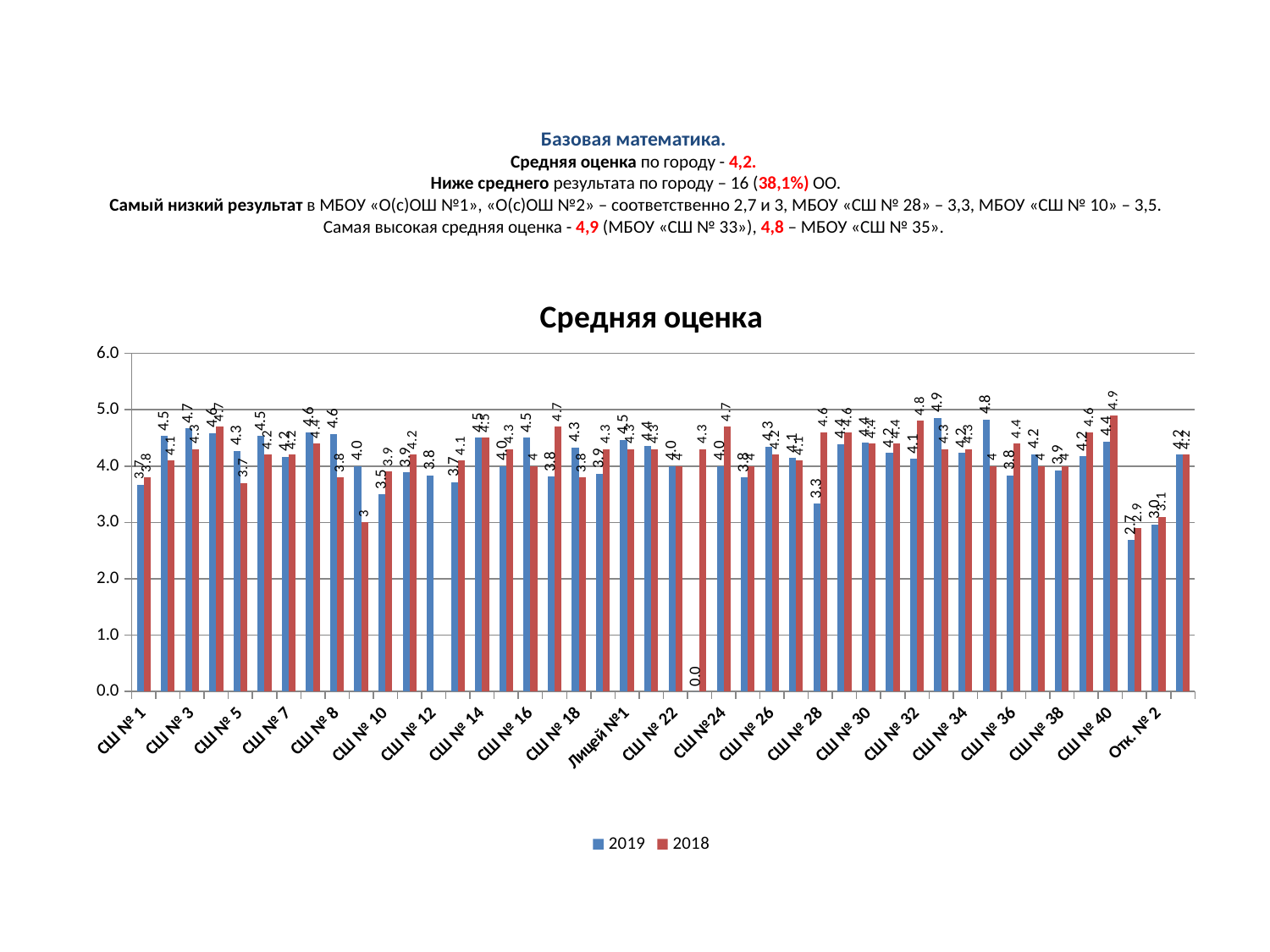
What is the 2019 value for СШ № 28? 3.3 What are the two series named in the chart legend? 2019 and 2018 What kind of chart is shown on the slide? bar chart What is the difference between the 2018 and 2019 values for СШ № 28? 1.3 What is the 2018 value for СШ № 28? 4.6 Is the 2019 value for СШ № 28 greater or less than 4.0? less What is the highest value plotted for the 2019 series? 4.9 Is the 2019 value for СШ № 1 greater or less than 4.0? less What is the lowest value plotted on the chart? 0.0 What is the title of the chart? Средняя оценка How many series does the legend of the chart list? 2 For СШ № 28, which series has the larger value, 2019 or 2018? 2018